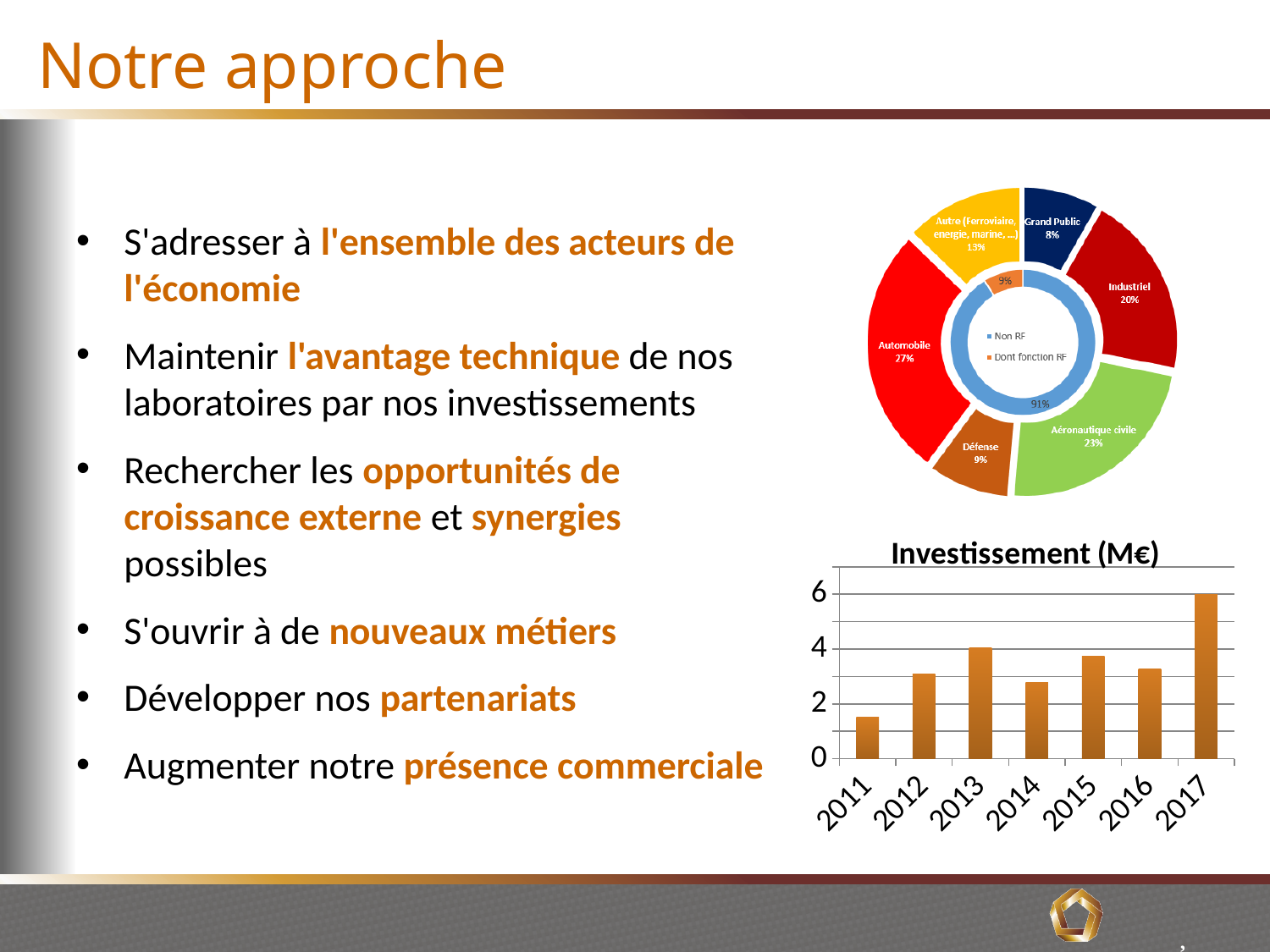
In the doughnut chart at the top right, what share is labelled Non RF in the inner ring? 91% In the 'Investissement (M€)' chart, which year has the lowest value? 2011 In the doughnut chart at the top right, what is the difference between the Automobile share and the Industriel share? 7% In the doughnut chart at the top right, what share does Aéronautique civile represent? 23% In the 'Investissement (M€)' chart, which year has the highest value? 2017 In the doughnut chart at the top right, how many sectors are shown in the outer ring? 6 In the doughnut chart at the top right, which sector has the smallest share? Grand Public In the 'Investissement (M€)' chart, how many years are shown on the x axis? 7 In the doughnut chart at the top right, what share does Automobile represent? 27% In the 'Investissement (M€)' chart, is the value for 2017 greater or less than 4? greater In the doughnut chart at the top right, which sector has the largest share? Automobile In the doughnut chart at the top right, which is larger: Défense or Industriel? Industriel